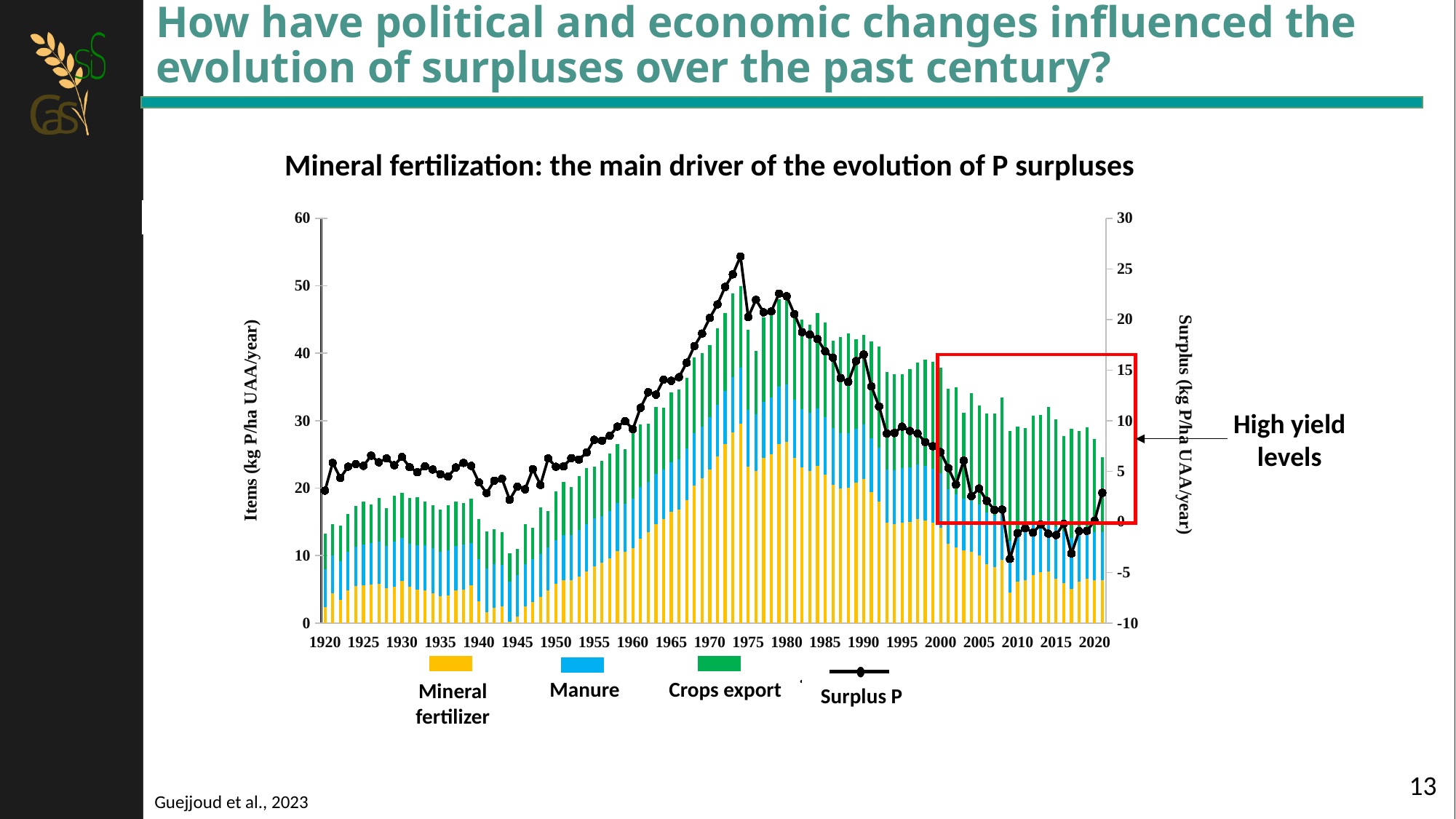
Which colour represents Mineral fertilizer in the chart? Yellow Is the Surplus P value in 1974 greater or less than 20 on the right axis? greater What is the title of the chart? Mineral fertilization: the main driver of the evolution of P surpluses Is the total height of the stacked bar in 1974 greater or less than 40 on the left axis? greater Which is larger, the Surplus P value in 1974 or in 2010? 1974 Is the total height of the stacked bar in 1945 greater or less than 20 on the left axis? less In which decade does the Surplus P line reach its highest value? 1970s How many series does the chart legend list? 4 Does the Surplus P line generally rise or fall between 1975 and 2010? Fall What kind of chart is shown on the slide? A combined stacked bar and line chart